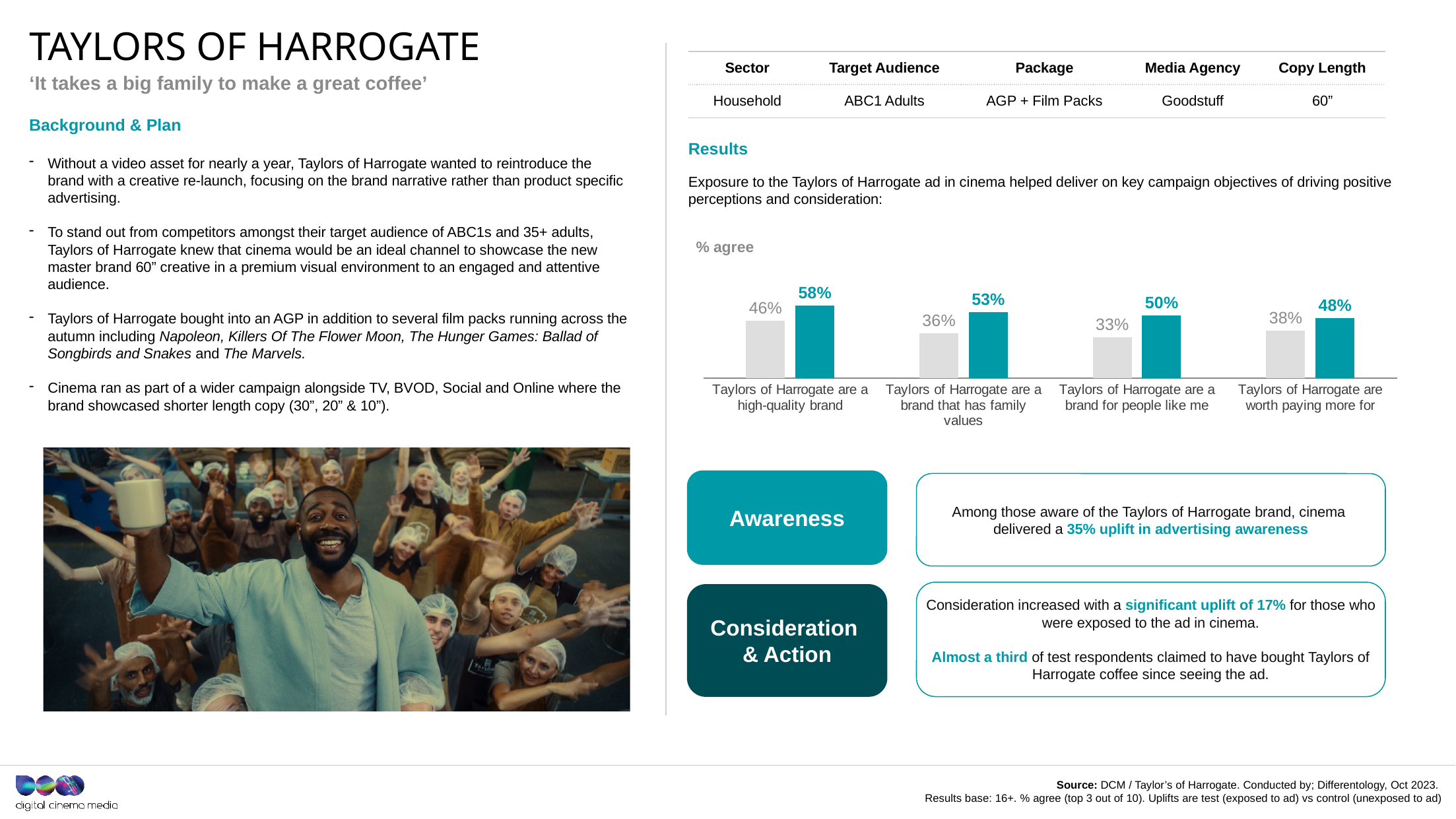
Which is larger: the grey bar for 'high-quality brand' or the grey bar for 'worth paying more for'? high-quality brand What is the value of the grey bar for 'Taylors of Harrogate are a brand for people like me'? 33% Which statement has the highest teal bar value? Taylors of Harrogate are a high-quality brand What is the difference between the teal and grey bars for 'Taylors of Harrogate are a brand that has family values'? 17 percentage points Which statement has the lowest grey bar value? Taylors of Harrogate are a brand for people like me What is the difference between the teal and grey bars for 'Taylors of Harrogate are worth paying more for'? 10 percentage points What is the value of the teal bar for 'Taylors of Harrogate are worth paying more for'? 48% What type of chart is used to show the % agree results? Bar chart What is the label shown above the chart indicating what the values represent? % agree How many statements (categories) are shown on the chart? 4 What is the value of the teal bar for 'Taylors of Harrogate are a high-quality brand'? 58% What is the value of the grey bar for 'Taylors of Harrogate are a brand that has family values'? 36%